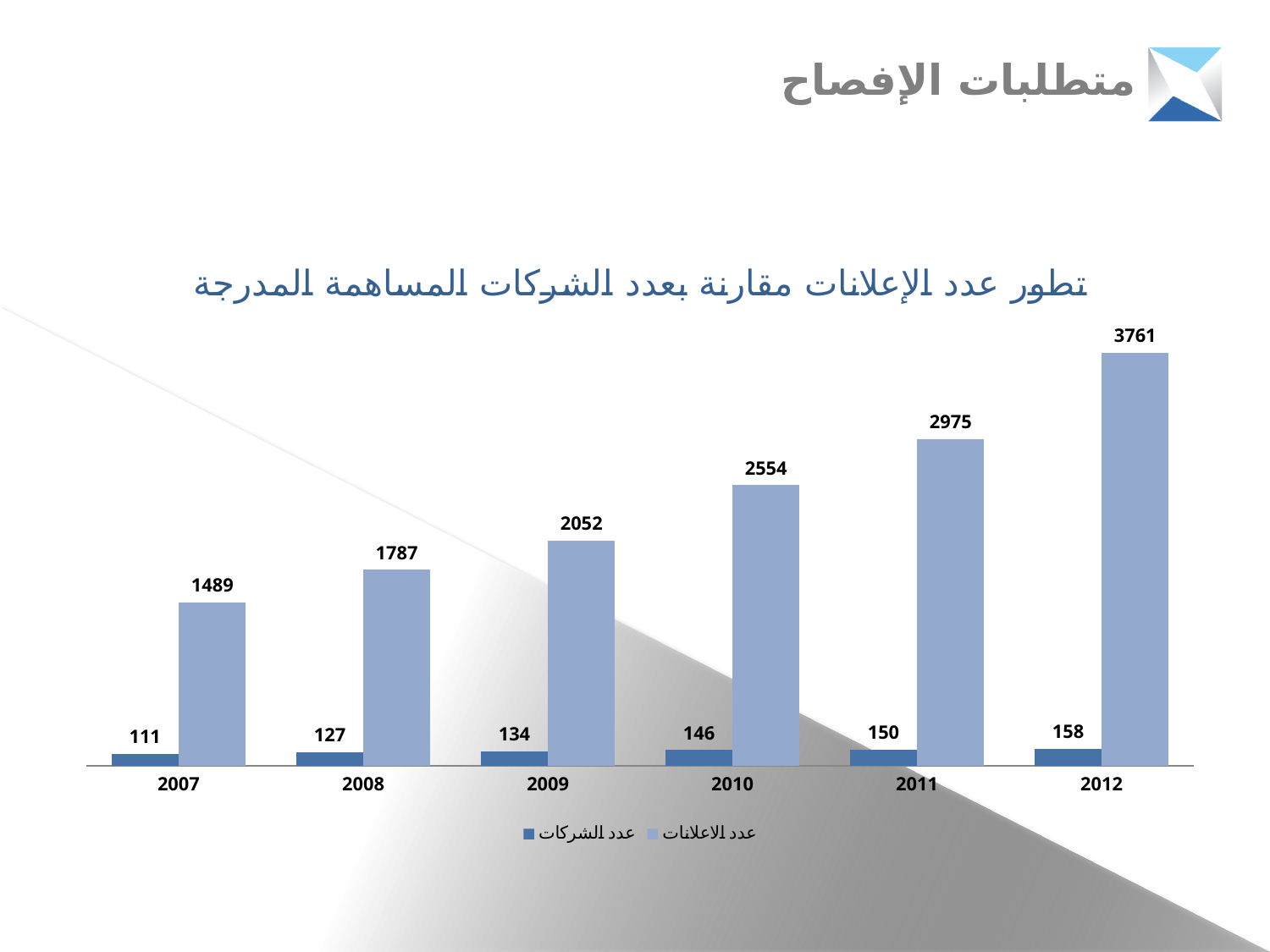
Do the values for عدد الاعلانات rise or fall from 2007 to 2012? rise What is the value of عدد الاعلانات for 2012? 3761 What kind of chart is shown on the slide? bar chart Which is larger: عدد الاعلانات in 2009 or in 2008? 2009 What is the difference between عدد الشركات in 2012 and in 2007? 47 What is the value of عدد الشركات for 2008? 127 What is the difference between عدد الاعلانات in 2012 and in 2011? 786 How many series does the legend list? 2 How many years are shown on the x axis? 6 Which year has the lowest value for عدد الشركات? 2007 Which year has the highest value for عدد الاعلانات? 2012 What is the value of عدد الاعلانات for 2010? 2554